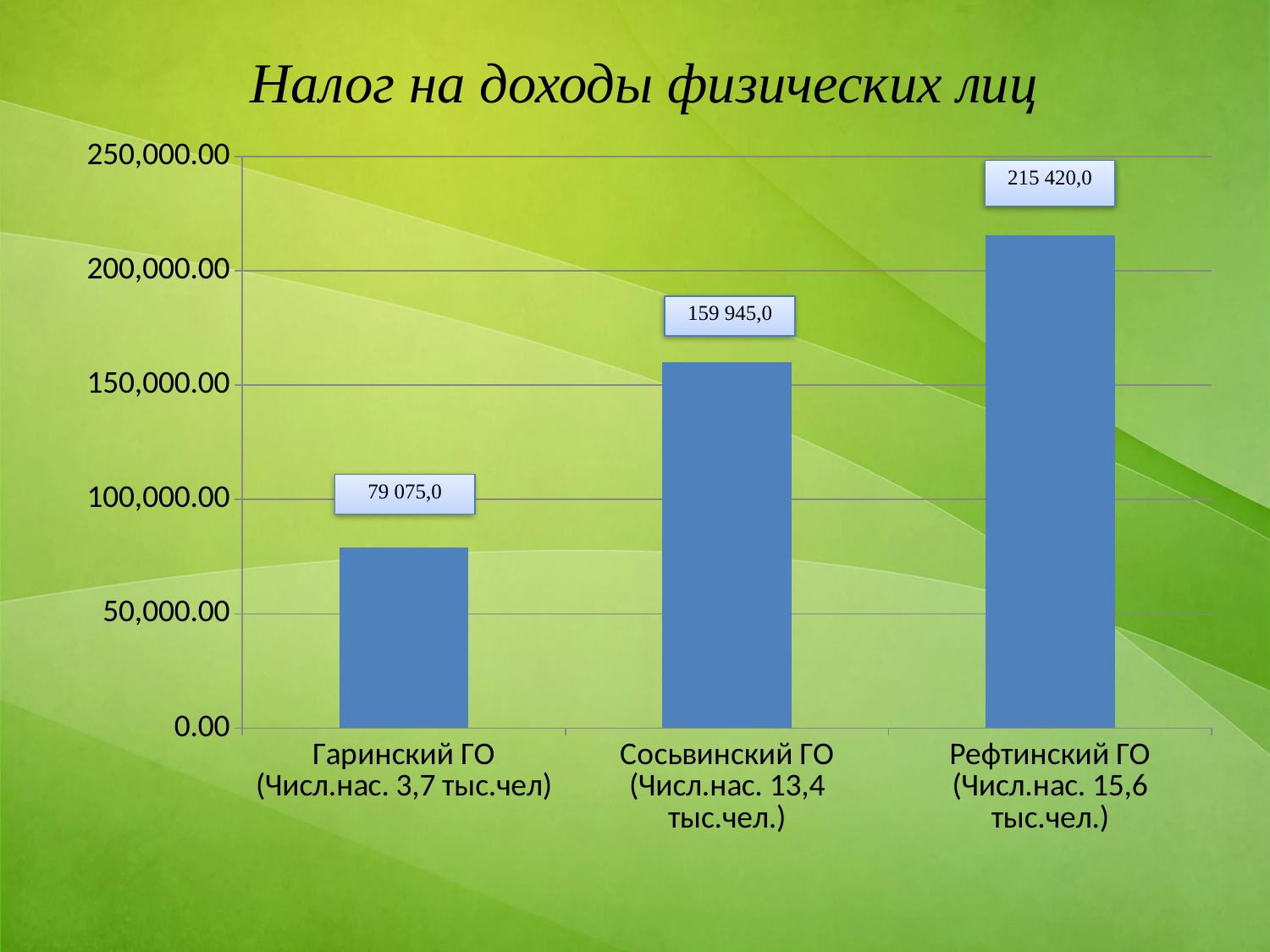
Which category has the highest value? Рефтинский ГО What is the difference between the values for Сосьвинский ГО and Гаринский ГО? 80 870,0 Which category has the lowest value? Гаринский ГО How many categories are shown on the chart? 3 What kind of chart is shown on the slide? bar chart What is the value for Сосьвинский ГО? 159 945,0 What is the title of the chart? Налог на доходы физических лиц What is the value for Рефтинский ГО? 215 420,0 Which is larger, the value for Сосьвинский ГО or the value for Гаринский ГО? Сосьвинский ГО Is the value for Рефтинский ГО greater or less than 200,000.00? greater What is the value for Гаринский ГО? 79 075,0 What is the difference between the values for Рефтинский ГО and Сосьвинский ГО? 55 475,0